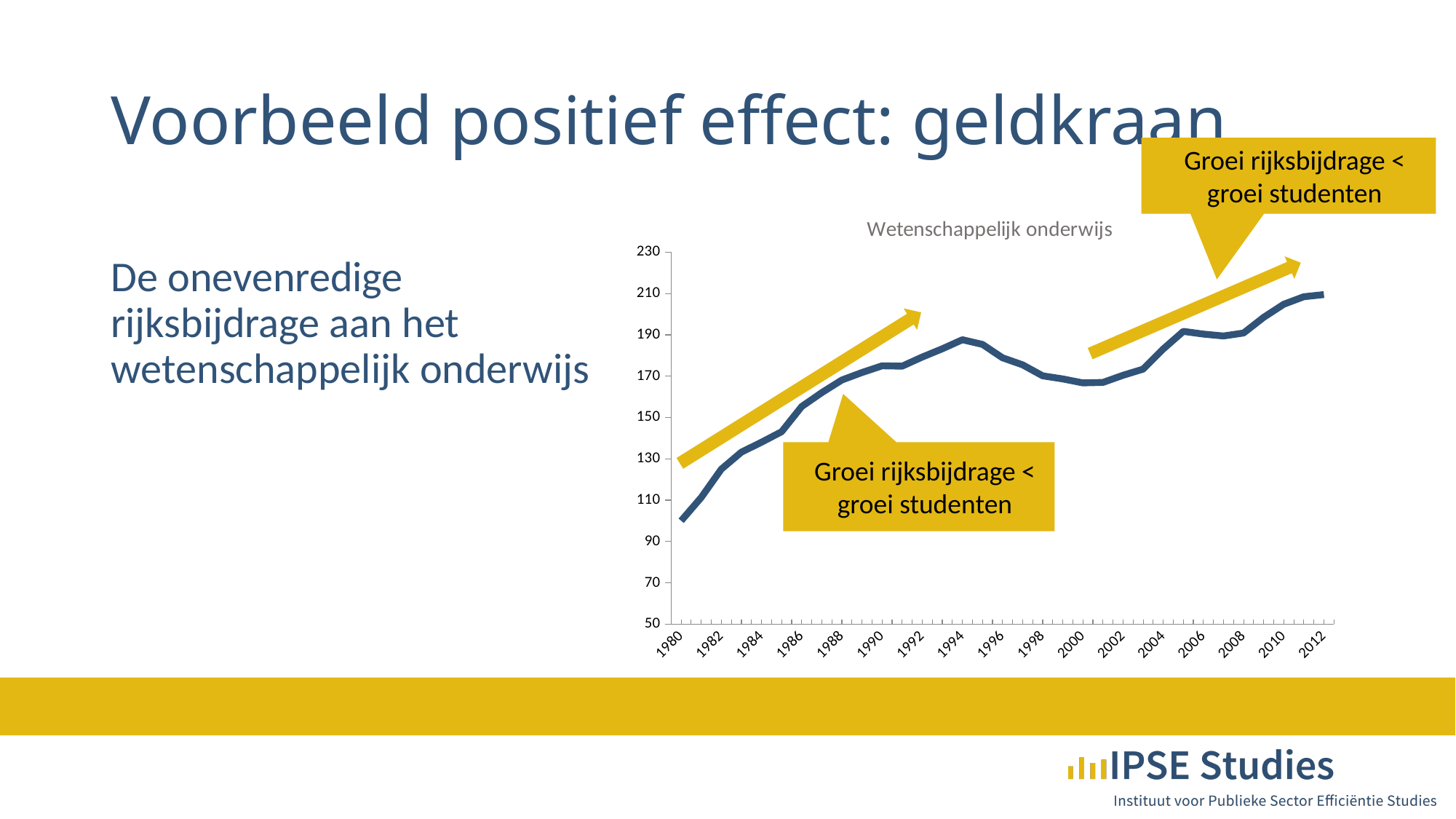
Do the values rise or fall between 2000 and 2012? rise Is the value for 2012 greater or less than 190? greater What kind of chart is shown on the slide? line chart Which year has the lowest value on the chart? 1980 Do the values rise or fall between 1994 and 2000? fall Is the value for 1980 greater or less than 110? less Is the value for 1988 greater or less than 150? greater Which is larger, the value for 2012 or the value for 1994? 2012 Which is larger, the value for 1994 or the value for 2000? 1994 How many year labels are shown on the x axis? 17 What is the title of the chart? Wetenschappelijk onderwijs